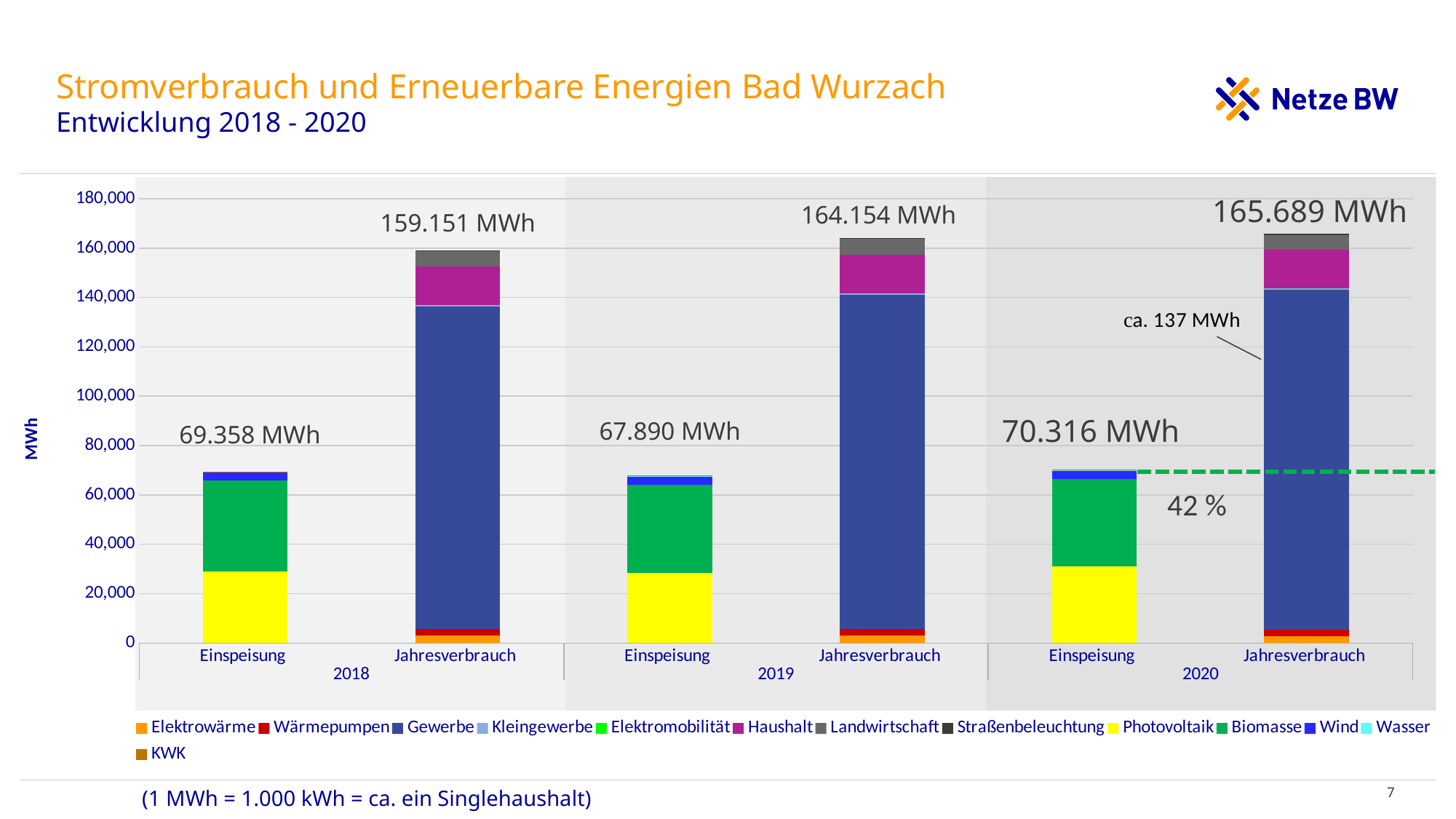
Is the Photovoltaik value in the 2020 Einspeisung bar greater or less than 20,000? greater What is the difference between the Jahresverbrauch totals of 2020 and 2018? 6.538 MWh What is the total Einspeisung for 2018? 69.358 MWh What is the total Jahresverbrauch for 2019? 164.154 MWh What is the total Einspeisung for 2019? 67.890 MWh What type of chart is shown on the slide? Stacked bar chart Which is larger, the Einspeisung total for 2020 or for 2018? 2020 Which year has the lowest Einspeisung total? 2019 What percentage is shown next to the dashed green line in the 2020 section? 42 % How many series does the legend list? 13 What is the total Jahresverbrauch for 2020? 165.689 MWh Which year has the highest Jahresverbrauch total? 2020